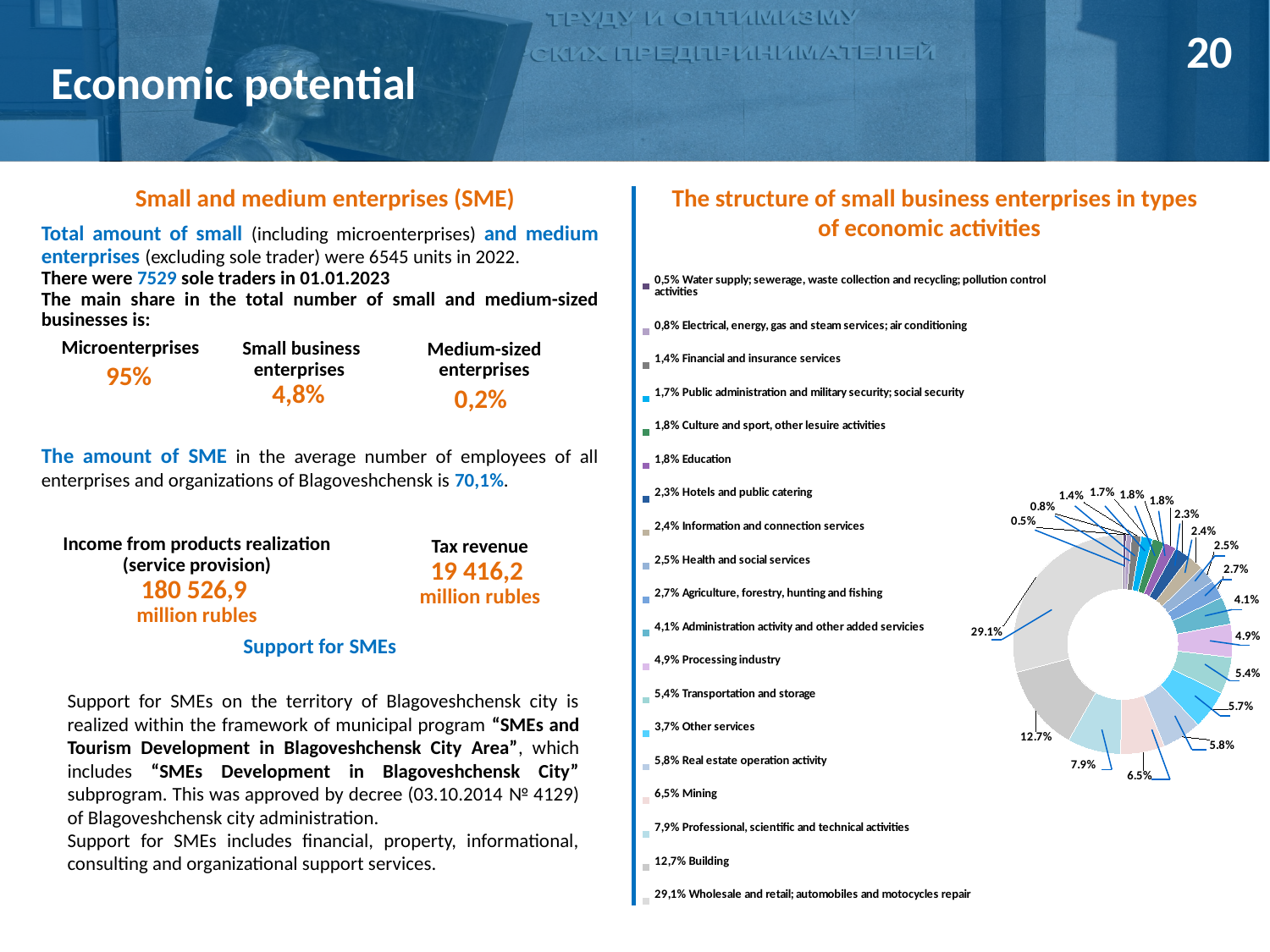
In the structure of small business enterprises chart, which has the larger share: Mining or Processing industry? Mining What share does Processing industry have in the structure of small business enterprises chart? 4.9% What share does Education have in the structure of small business enterprises chart? 1.8% What share does Building have in the structure of small business enterprises chart? 12.7% What type of chart is shown under the title "The structure of small business enterprises in types of economic activities"? doughnut chart What share does Mining have in the structure of small business enterprises chart? 6.5% In the structure of small business enterprises chart, how much larger is the share of Wholesale and retail; automobiles and motocycles repair than the share of Building? 16.4% How many types of economic activity are listed in the legend of the structure of small business enterprises chart? 19 What share does Professional, scientific and technical activities have in the structure of small business enterprises chart? 7.9% In the structure of small business enterprises chart, how much larger is the share of Building than the share of Mining? 6.2% In the chart of the structure of small business enterprises, which type of economic activity has the smallest share? Water supply; sewerage, waste collection and recycling; pollution control activities In the chart of the structure of small business enterprises, which type of economic activity has the largest share? Wholesale and retail; automobiles and motocycles repair